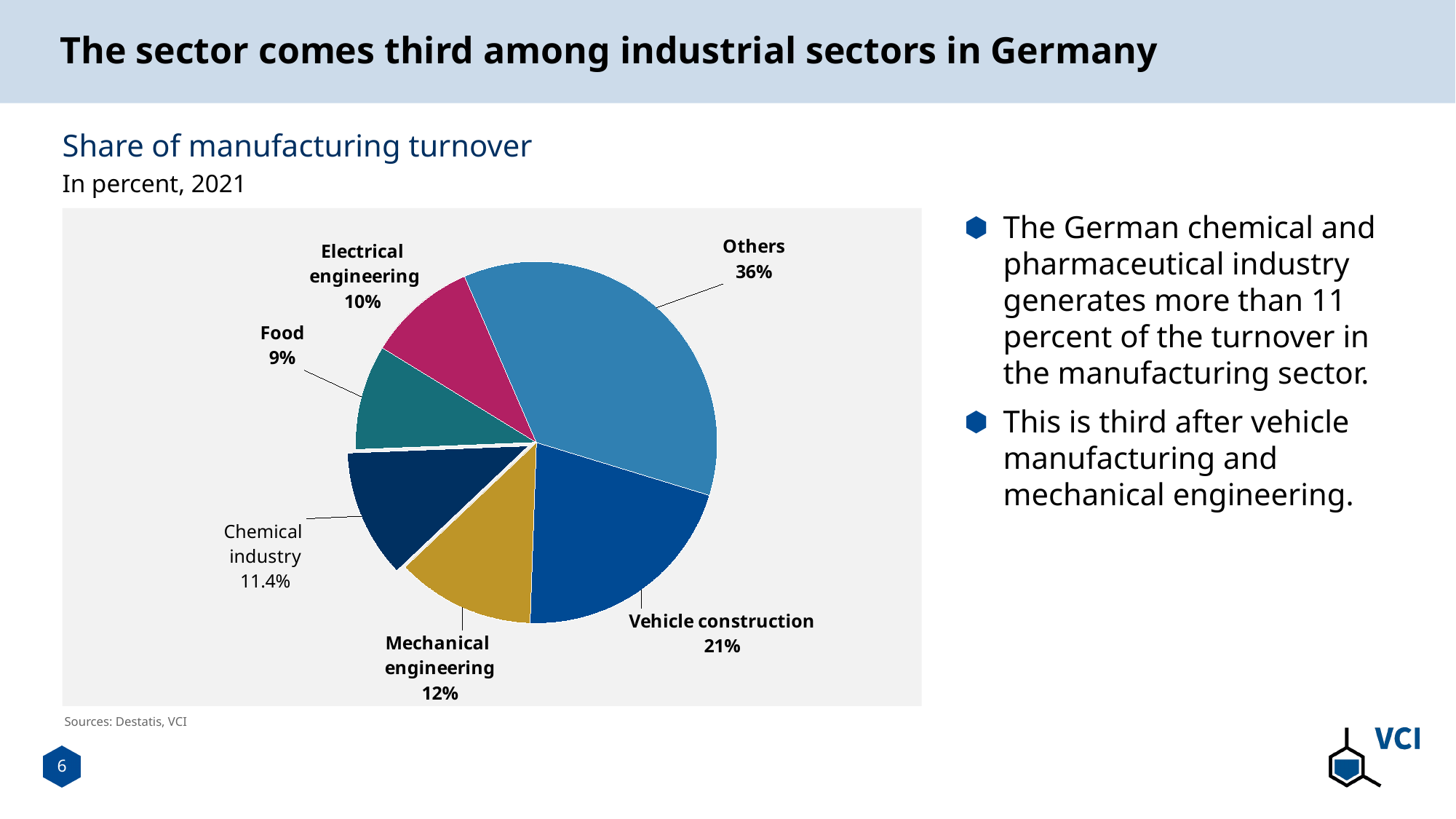
Which is larger, the share for the chemical industry or the share for electrical engineering? Chemical industry What type of chart is shown on the slide? Pie chart What is the difference in percentage points between vehicle construction and mechanical engineering? 9 What is the title of the chart? Share of manufacturing turnover What share is shown for mechanical engineering? 12% What share of manufacturing turnover does vehicle construction hold? 21% What share of manufacturing turnover does the chemical industry hold? 11.4% How many slices does the pie chart have? 6 What share is shown for food? 9% Which slice of the pie is the smallest? Food Which slice of the pie is the largest? Others What share is shown for electrical engineering? 10%